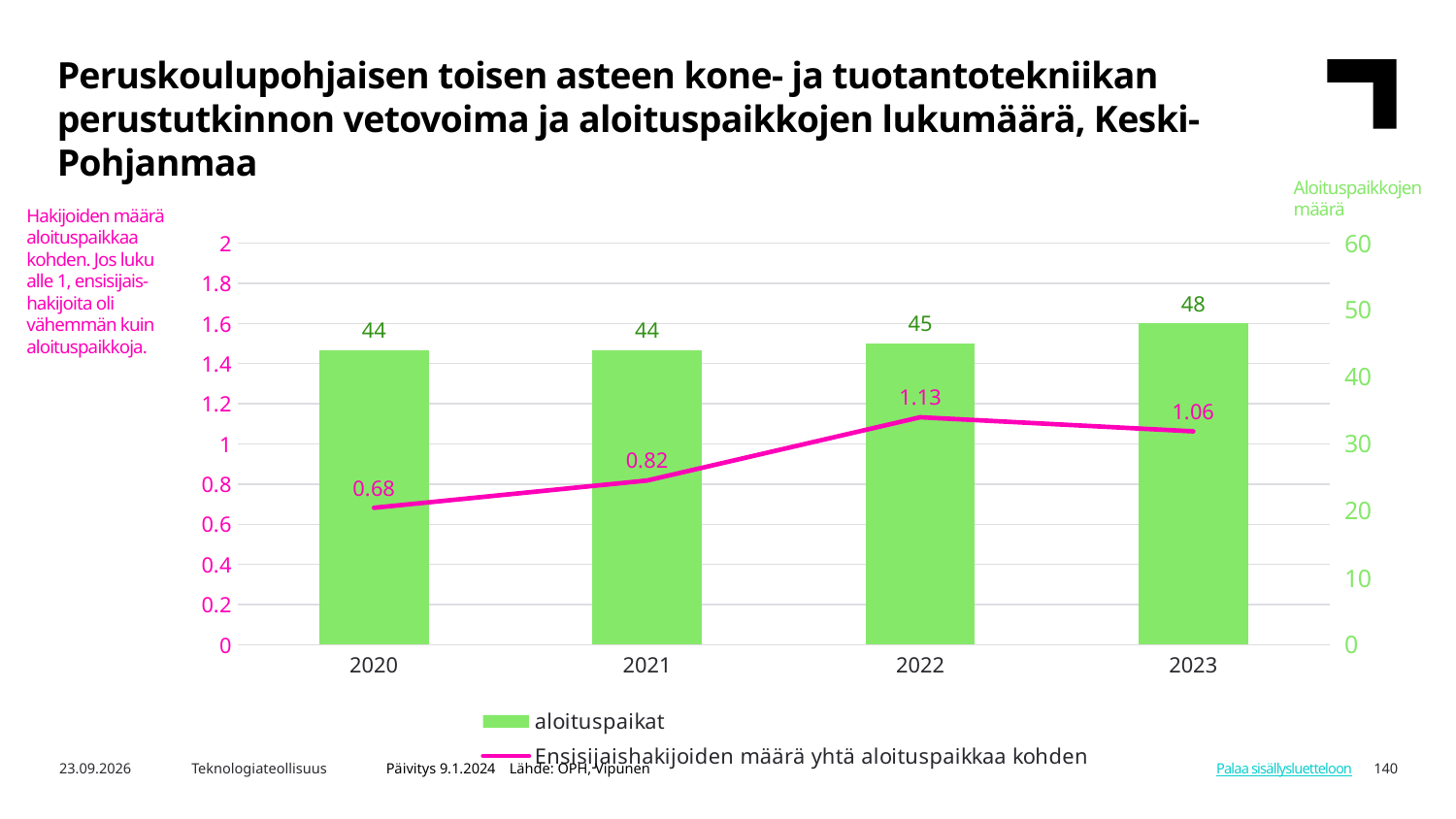
Which year has a higher Ensisijaishakijoiden määrä yhtä aloituspaikkaa kohden value, 2021 or 2023? 2023 How many series does the legend list? 2 What kind of chart is shown on the slide? Combined bar and line chart What is the value of aloituspaikat in 2023? 48 In which year is the aloituspaikat value highest? 2023 What colour are the aloituspaikat bars? Green In which year is the Ensisijaishakijoiden määrä yhtä aloituspaikkaa kohden value lowest? 2020 What is the difference between the aloituspaikat values in 2023 and 2020? 4 How many years are shown on the x axis? 4 What is the value of Ensisijaishakijoiden määrä yhtä aloituspaikkaa kohden in 2020? 0.68 Does the aloituspaikat value rise or fall from 2022 to 2023? Rise What is the value of Ensisijaishakijoiden määrä yhtä aloituspaikkaa kohden in 2022? 1.13